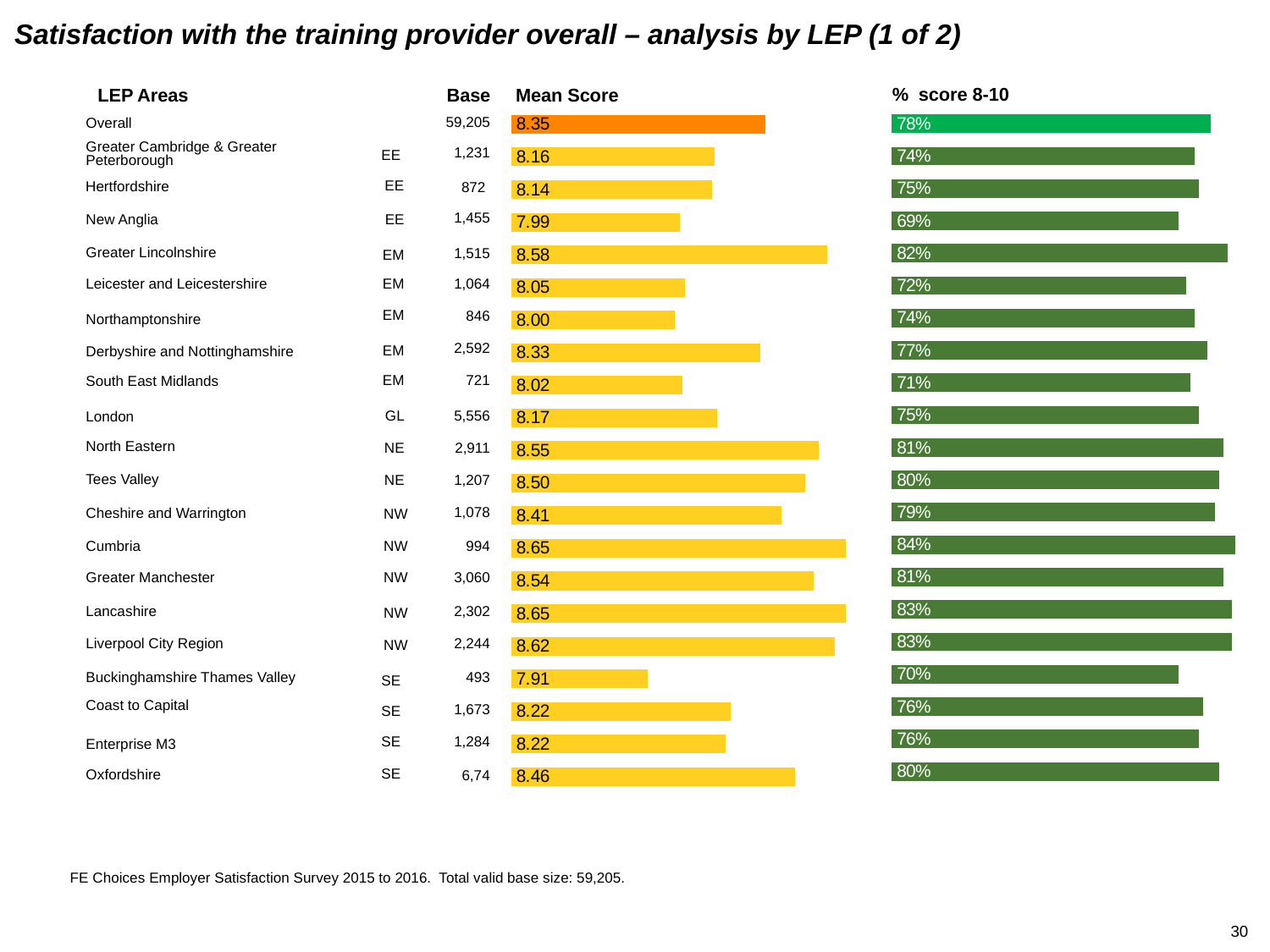
In the % score 8-10 chart, what is the value for Tees Valley? 80% How many bars are shown in the Mean Score chart, including Overall? 21 In the Mean Score chart, what is the difference between the mean scores for Liverpool City Region and London? 0.45 In the % score 8-10 chart, what is the difference between the values for Lancashire and Leicester and Leicestershire? 11% In the % score 8-10 chart, which has the higher value, Derbyshire and Nottinghamshire or South East Midlands? Derbyshire and Nottinghamshire In the Mean Score chart, what is the mean score for Overall? 8.35 In the Mean Score chart, what is the mean score for Greater Lincolnshire? 8.58 In the Mean Score chart, which has the higher mean score, North Eastern or Hertfordshire? North Eastern What kind of chart is used to show the % score 8-10 values? Bar chart In the % score 8-10 chart, which LEP area has the highest value? Cumbria In the % score 8-10 chart, which LEP area has the lowest value? New Anglia In the Mean Score chart, which LEP area has the lowest mean score? Buckinghamshire Thames Valley